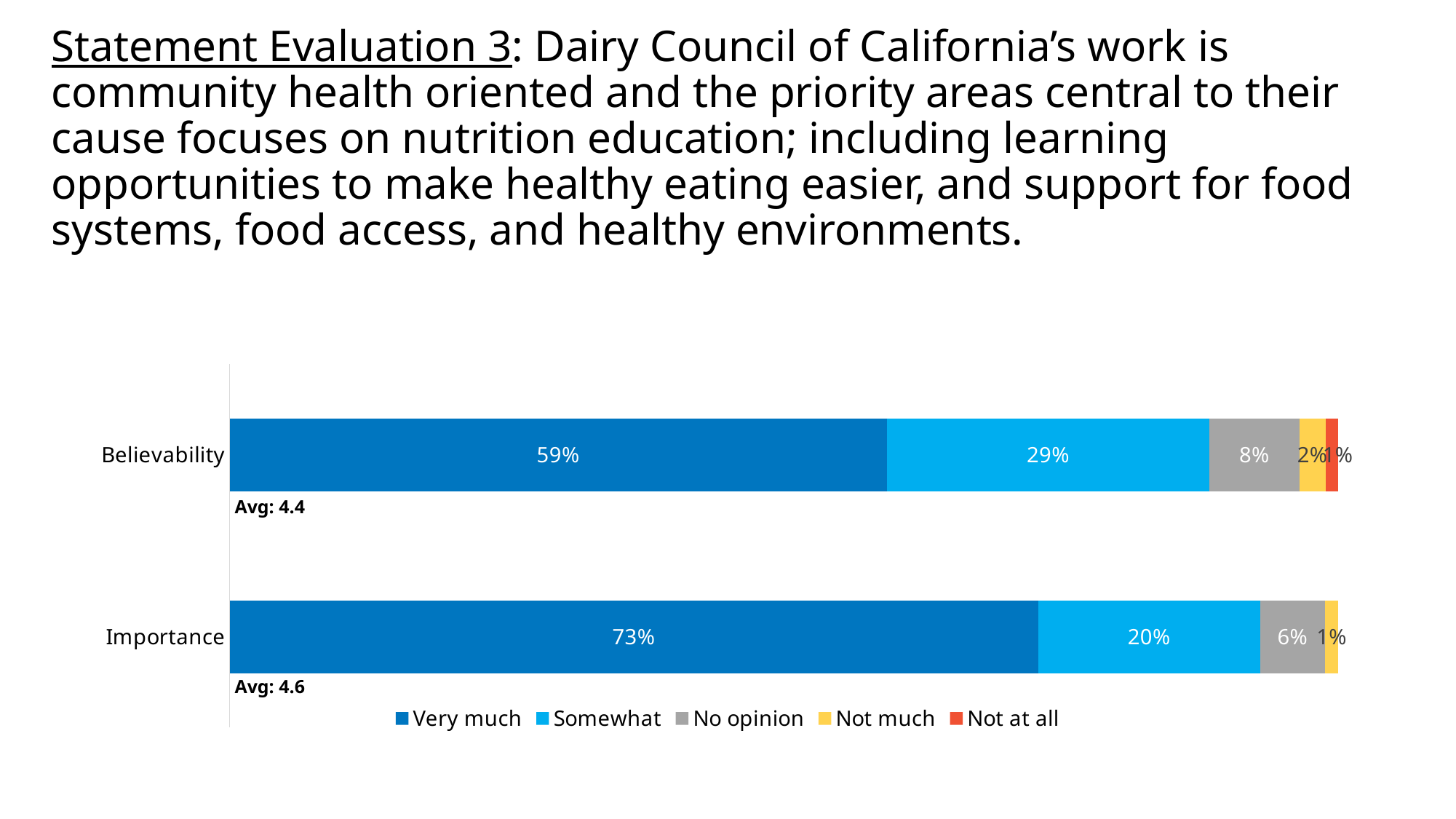
How many series does the legend list? 5 Which category has the higher "Very much" share, Believability or Importance? Importance What is the average score shown for Importance? 4.6 What is the difference between the "Very much" values for Importance and Believability? 14% What is the "Somewhat" value for Believability? 29% How many categories are shown on the chart? 2 What percentage of respondents answered "Very much" for Believability? 59% What type of chart is shown on the slide? Stacked bar chart What is the "No opinion" value for Importance? 6% What is the difference between the "Somewhat" values for Believability and Importance? 9% What percentage of respondents answered "Very much" for Importance? 73% What is the average score shown for Believability? 4.4